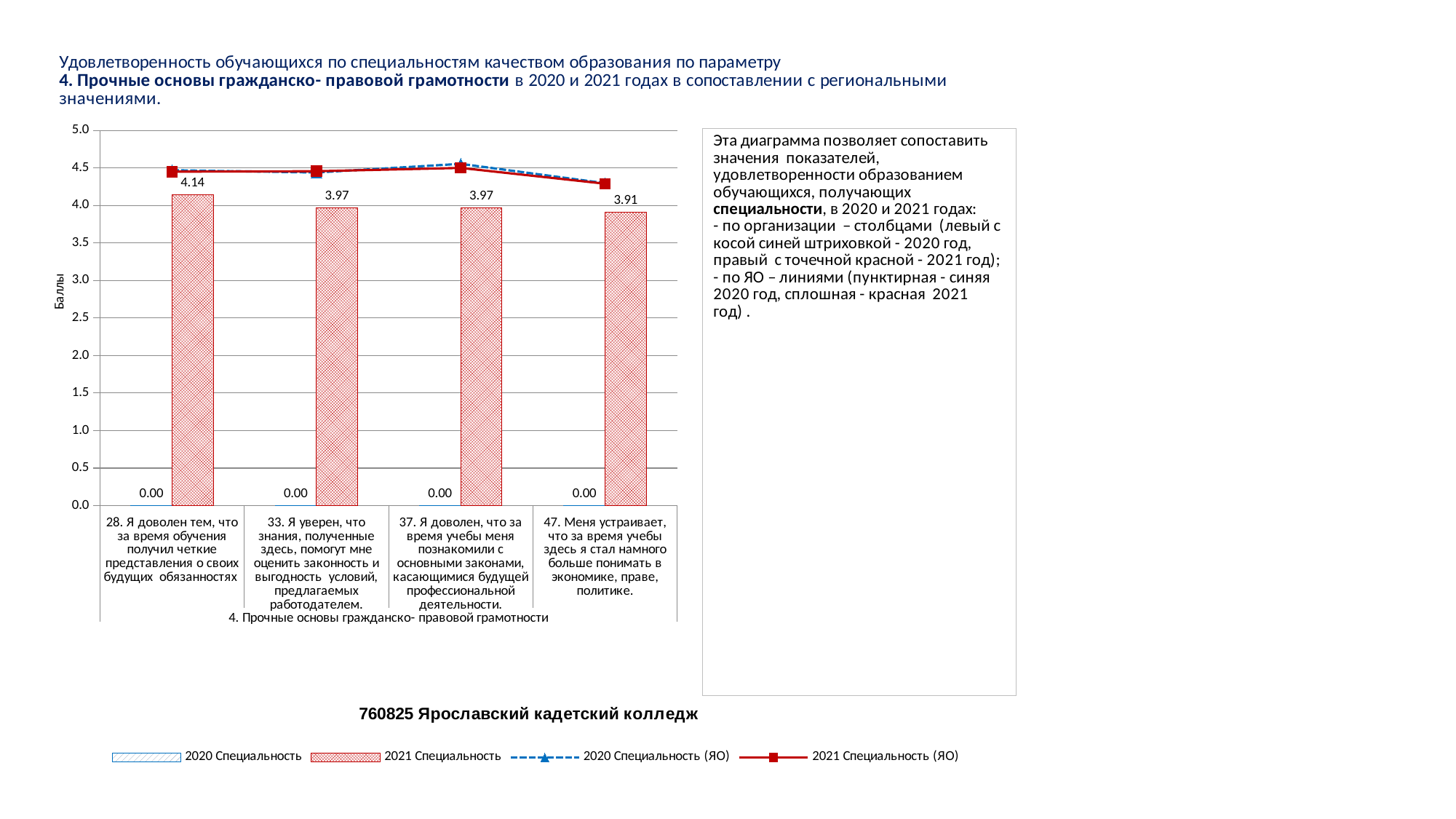
Is the 2021 Специальность (ЯО) line value for item 47 greater or less than 4.0? greater What is the 2020 Специальность value for item 33? 0.00 Which item has the highest 2021 Специальность value? 28. Я доволен тем, что за время обучения получил четкие представления о своих будущих обязанностях How many series does the legend list? 4 What is the difference between the 2021 Специальность values for item 28 and item 47? 0.23 What is the label of the y axis? Баллы What kind of chart is shown on the slide? Combined bar and line chart How many question items (categories) are shown on the x axis? 4 What is the 2021 Специальность value for item 28 (Я доволен тем, что за время обучения получил четкие представления о своих будущих обязанностях)? 4.14 Which item has the lowest 2021 Специальность value? 47. Меня устраивает, что за время учебы здесь я стал намного больше понимать в экономике, праве, политике What is the 2021 Специальность value for item 47 (Меня устраивает, что за время учебы здесь я стал намного больше понимать в экономике, праве, политике)? 3.91 Is the 2021 Специальность (ЯО) value for item 28 greater or less than the 2021 Специальность bar for item 28? greater